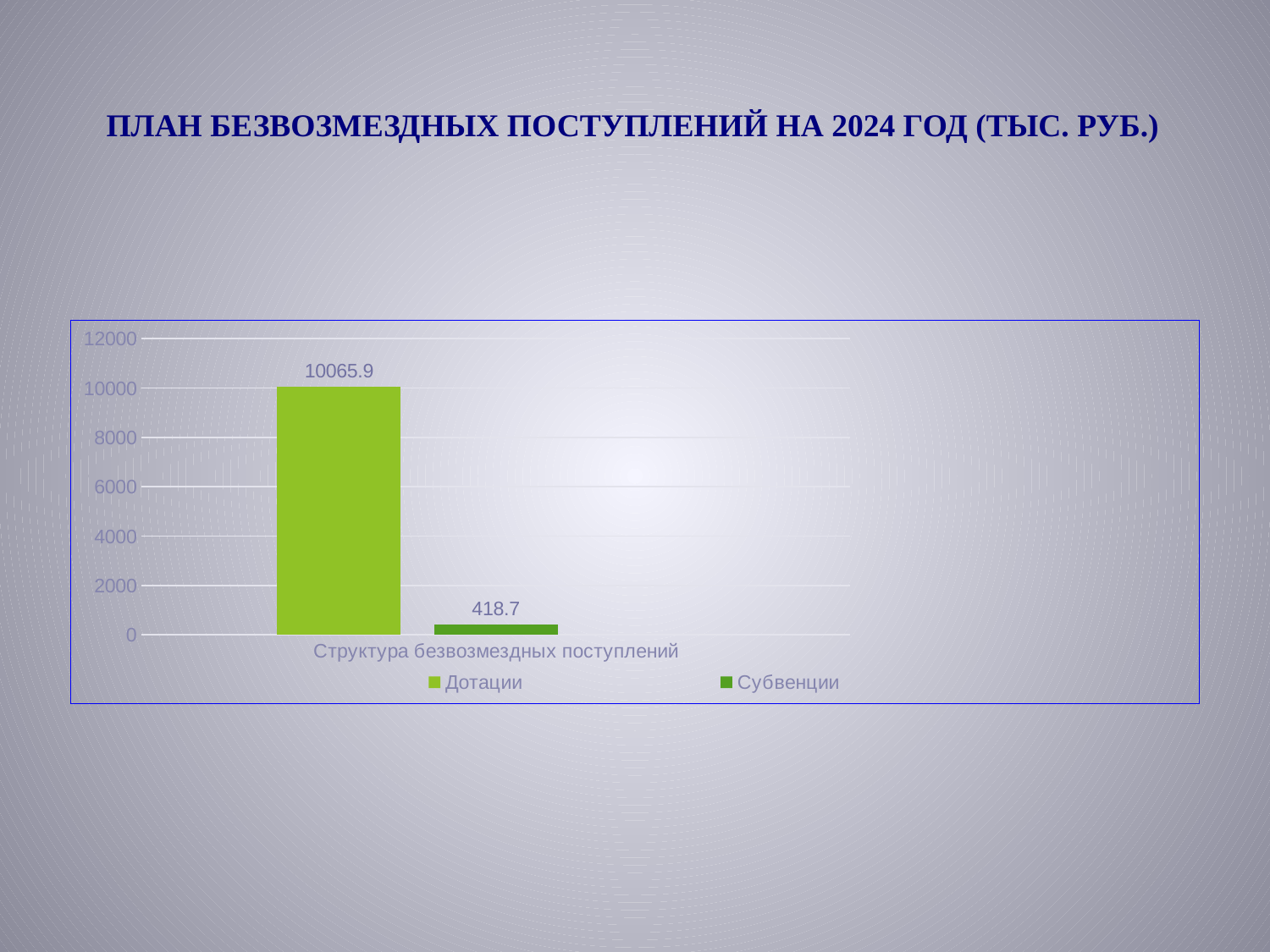
What is the category label shown on the x axis? Структура безвозмездных поступлений What kind of chart is shown on the slide? bar chart Is the value for Дотации greater or less than 10000? greater What is the value for Субвенции? 418.7 Is the value for Субвенции greater or less than 2000? less Which is larger, the value for Дотации or the value for Субвенции? Дотации How many series does the legend list? 2 What is the difference between the values for Дотации and Субвенции? 9647.2 What is the value for Дотации? 10065.9 What is the title of the slide above the chart? ПЛАН БЕЗВОЗМЕЗДНЫХ ПОСТУПЛЕНИЙ НА 2024 ГОД (ТЫС. РУБ.) Which series has the highest value? Дотации Which series has the lowest value? Субвенции